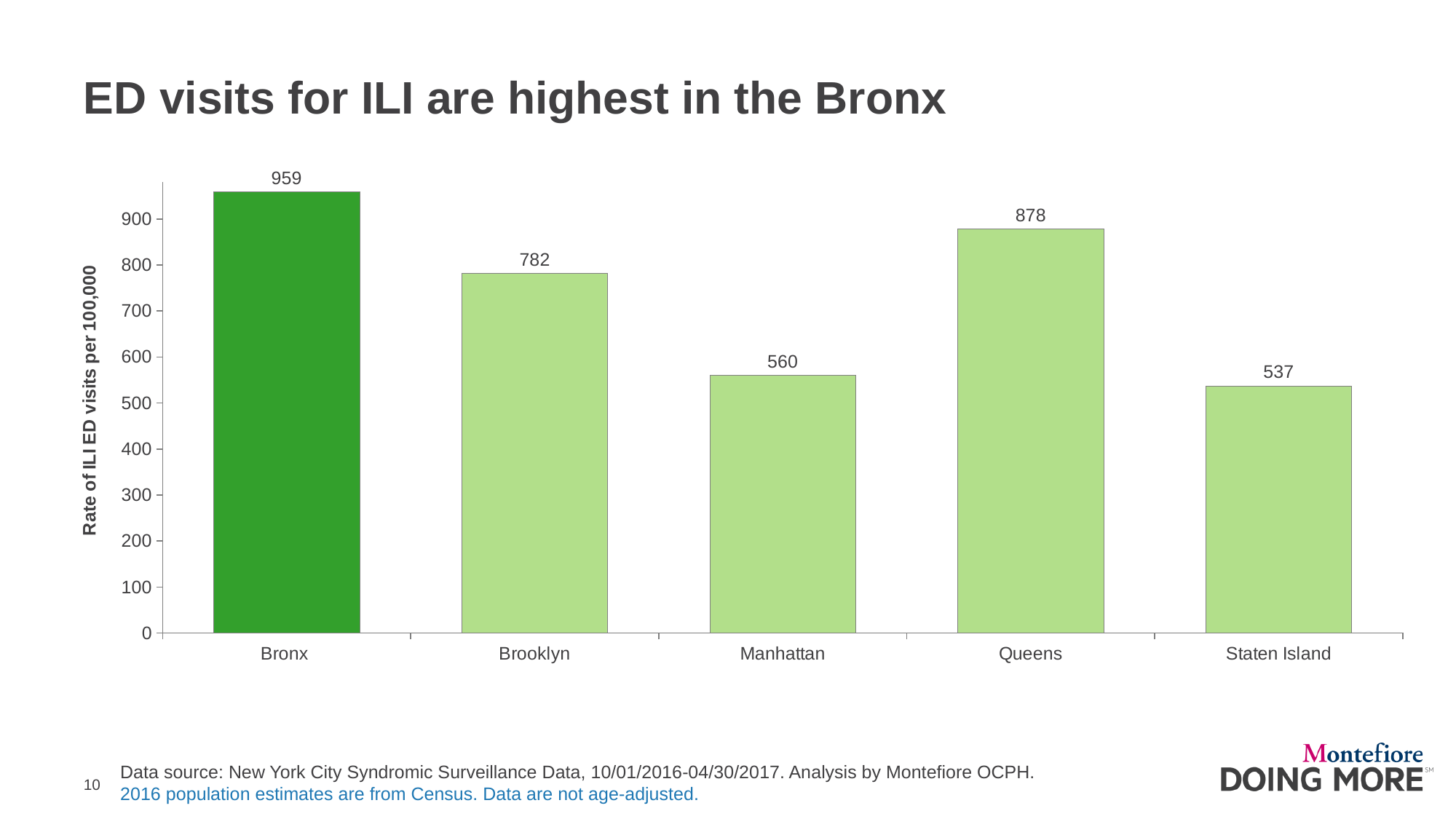
Is the rate of ILI ED visits for Manhattan greater or less than 600? less What is the difference between the Bronx and Brooklyn rates of ILI ED visits per 100,000? 177 How many boroughs are shown on the chart? 5 What kind of chart is shown on the slide? Bar chart Which has a higher rate of ILI ED visits, Brooklyn or Queens? Queens What is the rate of ILI ED visits per 100,000 for Manhattan? 560 Which borough has the lowest rate of ILI ED visits? Staten Island What is the difference between the Queens and Staten Island rates of ILI ED visits per 100,000? 341 What is the rate of ILI ED visits per 100,000 for the Bronx? 959 Which borough has the highest rate of ILI ED visits? Bronx Which bar is shaded a darker green than the others? Bronx What is the rate of ILI ED visits per 100,000 for Queens? 878